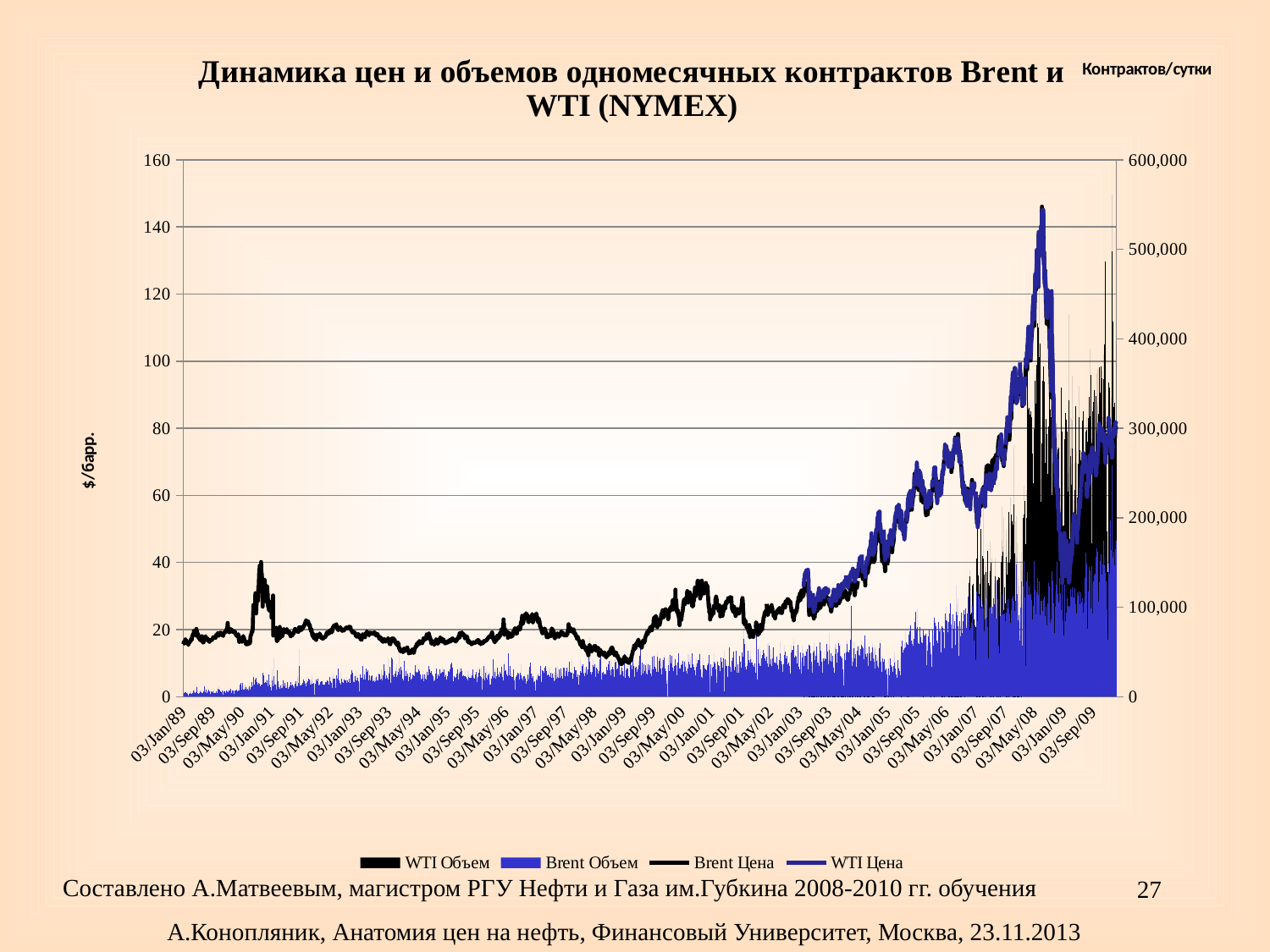
Do the contract volumes generally rise or fall from 1989 to 2009? rise Do the Brent and WTI prices generally rise or fall between 2003 and mid-2008? rise Is the peak Brent price reached in 2008 greater or less than 120 $/барр.? greater What kind of chart is this? Combined bar and line chart What is the maximum value shown on the right vertical axis? 600,000 Which series is drawn in blue bars according to the legend? Brent Объем Is the Brent price at 03/Jan/89 greater or less than 40 $/барр.? less What is the label of the left vertical axis? $/барр. What is the maximum value shown on the left vertical axis? 160 How many series does the chart legend list? 4 What is the title of the chart? Динамика цен и объемов одномесячных контрактов Brent и WTI (NYMEX) Is the Brent price at 03/Jan/99 greater or less than 20 $/барр.? less